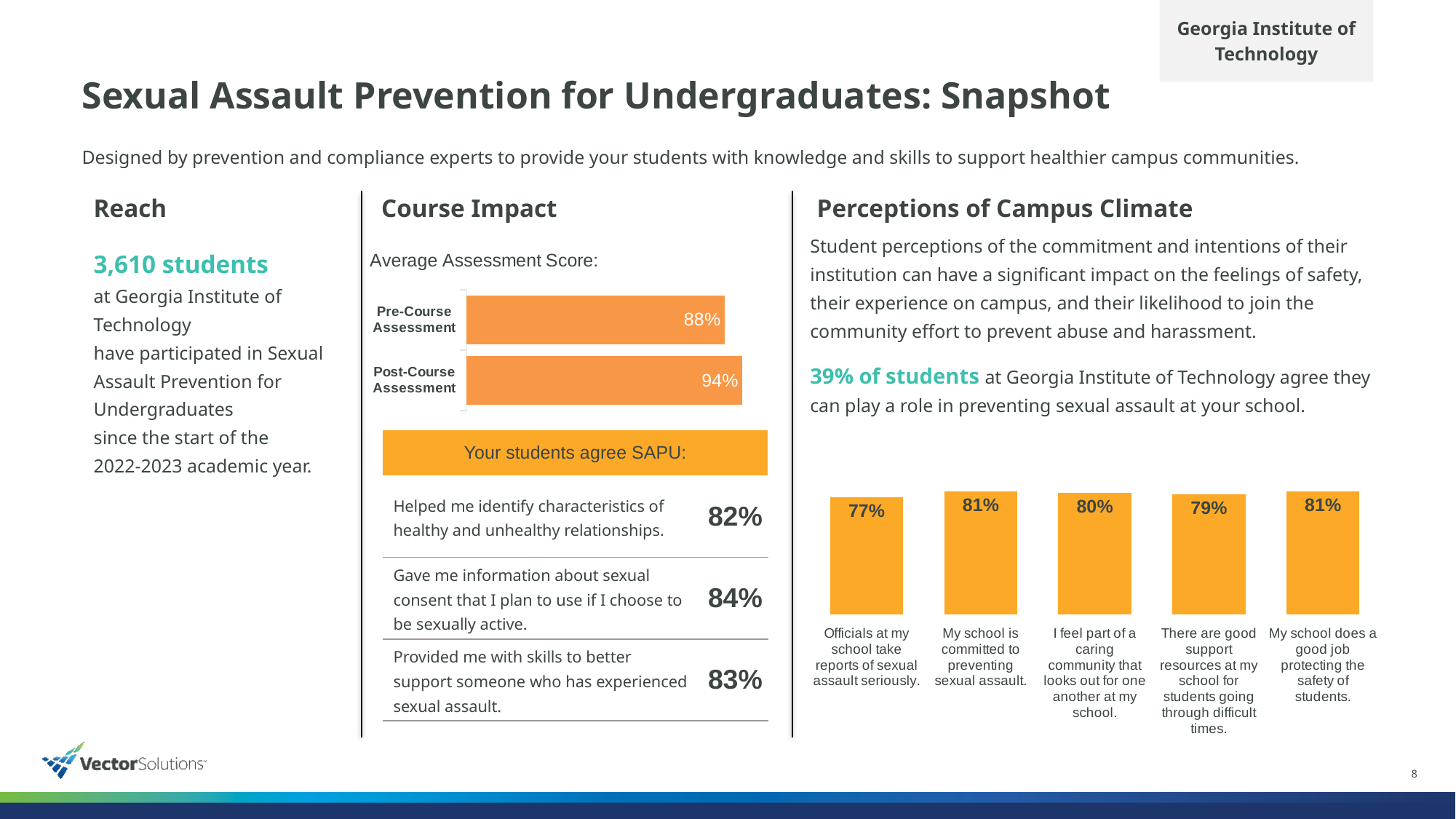
In the Average Assessment Score chart, what is the value for the Pre-Course Assessment? 88% In the Perceptions of Campus Climate chart, what is the difference between 'My school is committed to preventing sexual assault' and 'Officials at my school take reports of sexual assault seriously'? 4% What kind of chart is the Average Assessment Score chart? Bar chart In the Average Assessment Score chart, what is the difference between the Post-Course and Pre-Course Assessment scores? 6% How many bars are in the Perceptions of Campus Climate chart? 5 In the Perceptions of Campus Climate chart, what percentage of students agree that officials at their school take reports of sexual assault seriously? 77% In the Perceptions of Campus Climate chart, which statement has the lowest percentage? Officials at my school take reports of sexual assault seriously. In the Perceptions of Campus Climate chart, what is the value for 'I feel part of a caring community that looks out for one another at my school'? 80% In the Perceptions of Campus Climate chart, what is the value for 'There are good support resources at my school for students going through difficult times'? 79% In the Average Assessment Score chart, what is the value for the Post-Course Assessment? 94% How many bars are in the Average Assessment Score chart? 2 In the Average Assessment Score chart, which is larger, the Pre-Course or the Post-Course Assessment score? Post-Course Assessment